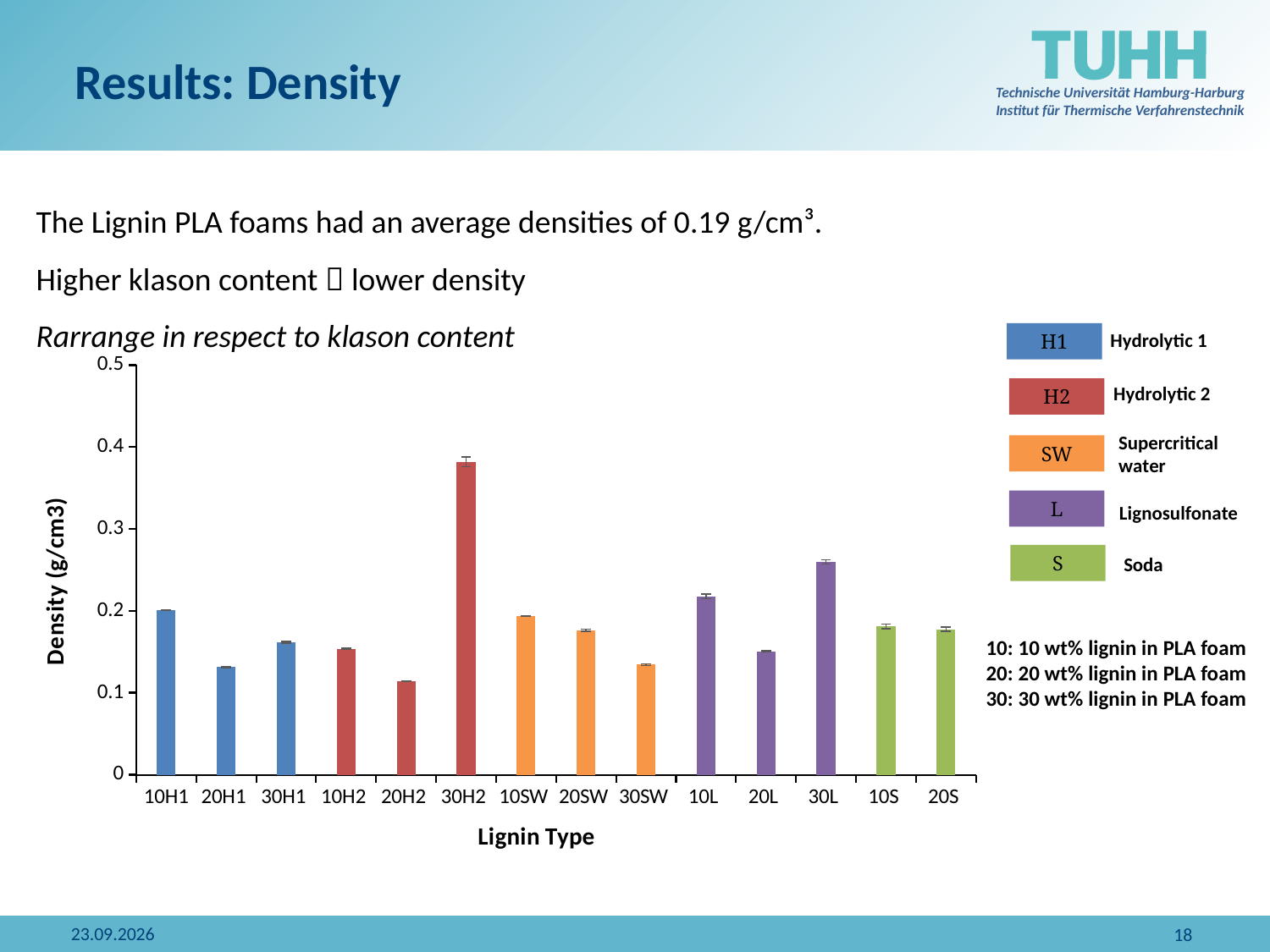
Is the density for 30SW greater or less than 0.2? less Which lignin type has the highest density in the chart? 30H2 Which has a higher density, 30H2 or 30L? 30H2 How many lignin types are plotted on the x axis? 14 Which has a higher density, 10H1 or 20H1? 10H1 What is the label of the y axis? Density (g/cm3) What kind of chart is shown on the slide? bar chart Which lignin type has the lowest density in the chart? 20H2 Is the density for 20H2 greater or less than 0.2? less Is the density for 30L greater or less than 0.2? greater What is the label of the x axis? Lignin Type